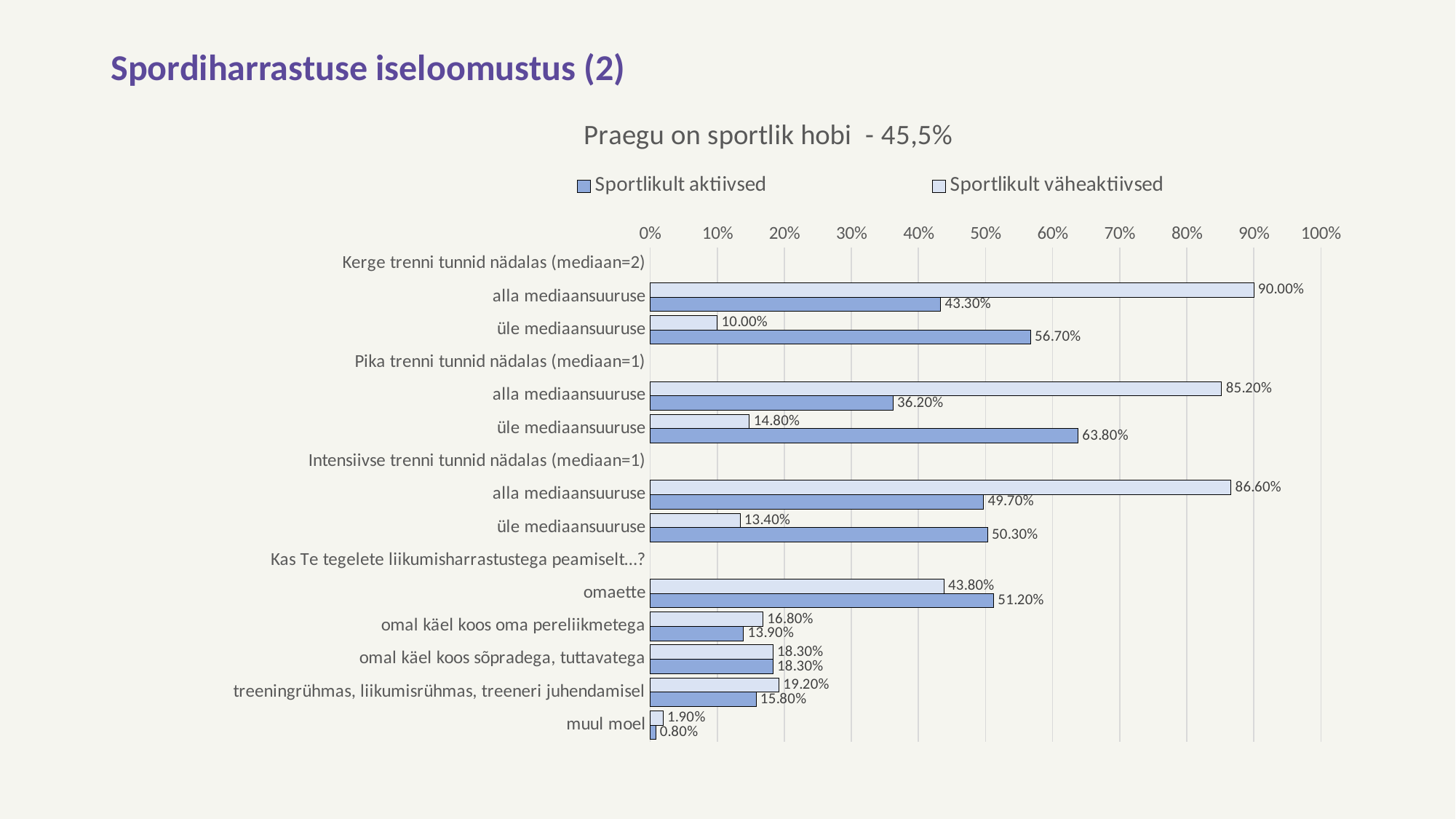
What is the value for Sportlikult väheaktiivsed for 'muul moel'? 1.90% Which category has the highest value for Sportlikult väheaktiivsed? alla mediaansuuruse (Kerge trenni tunnid nädalas) Which category has the lowest value for Sportlikult aktiivsed? muul moel What is the value for Sportlikult aktiivsed for 'üle mediaansuuruse' under 'Pika trenni tunnid nädalas (mediaan=1)'? 63.80% What is the difference between the Sportlikult aktiivsed and Sportlikult väheaktiivsed values for 'alla mediaansuuruse' under 'Intensiivse trenni tunnid nädalas (mediaan=1)'? 36.90% What kind of chart is shown on the slide? bar chart What is the value for Sportlikult aktiivsed for 'omaette'? 51.20% What is the value for Sportlikult väheaktiivsed for 'alla mediaansuuruse' under 'Kerge trenni tunnid nädalas (mediaan=2)'? 90.00% What is the title of the chart? Praegu on sportlik hobi - 45,5% How many series does the legend list? 2 Which series is shown with the darker blue bars? Sportlikult aktiivsed For 'treeningrühmas, liikumisrühmas, treeneri juhendamisel', which series has the larger value? Sportlikult väheaktiivsed